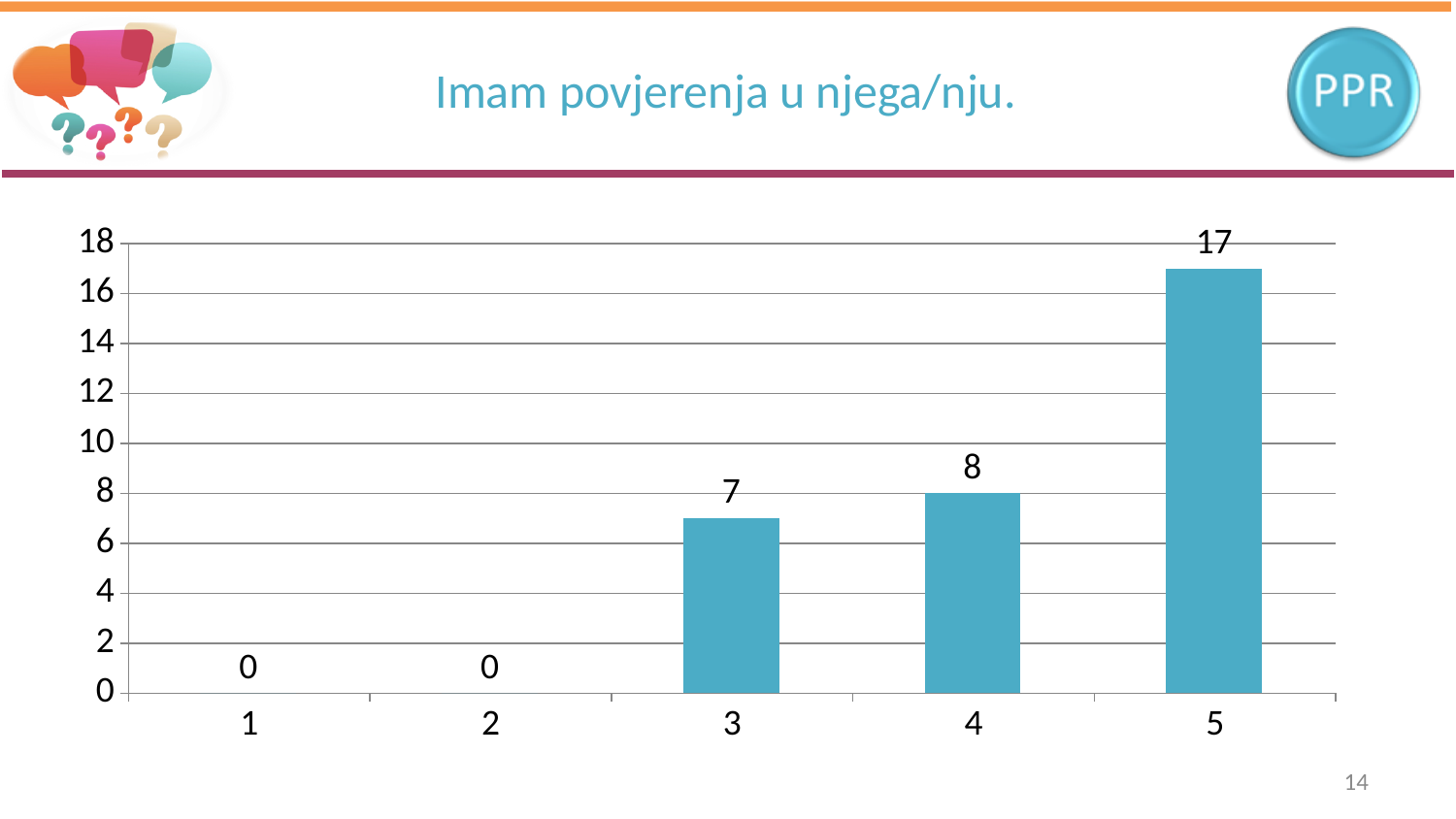
What is the difference between the values for category 5 and category 4? 9 What is the value for category 4? 8 What is the title of the slide? Imam povjerenja u njega/nju. What is the difference between the values for category 4 and category 3? 1 What kind of chart is shown on the slide? bar chart Which category has the highest value? 5 What is the value for category 3? 7 Is the value for category 5 greater or less than 10? greater How many categories are shown on the x axis? 5 What is the value for category 5? 17 What is the value for category 1? 0 Which is larger, the value for category 3 or the value for category 5? the value for category 5